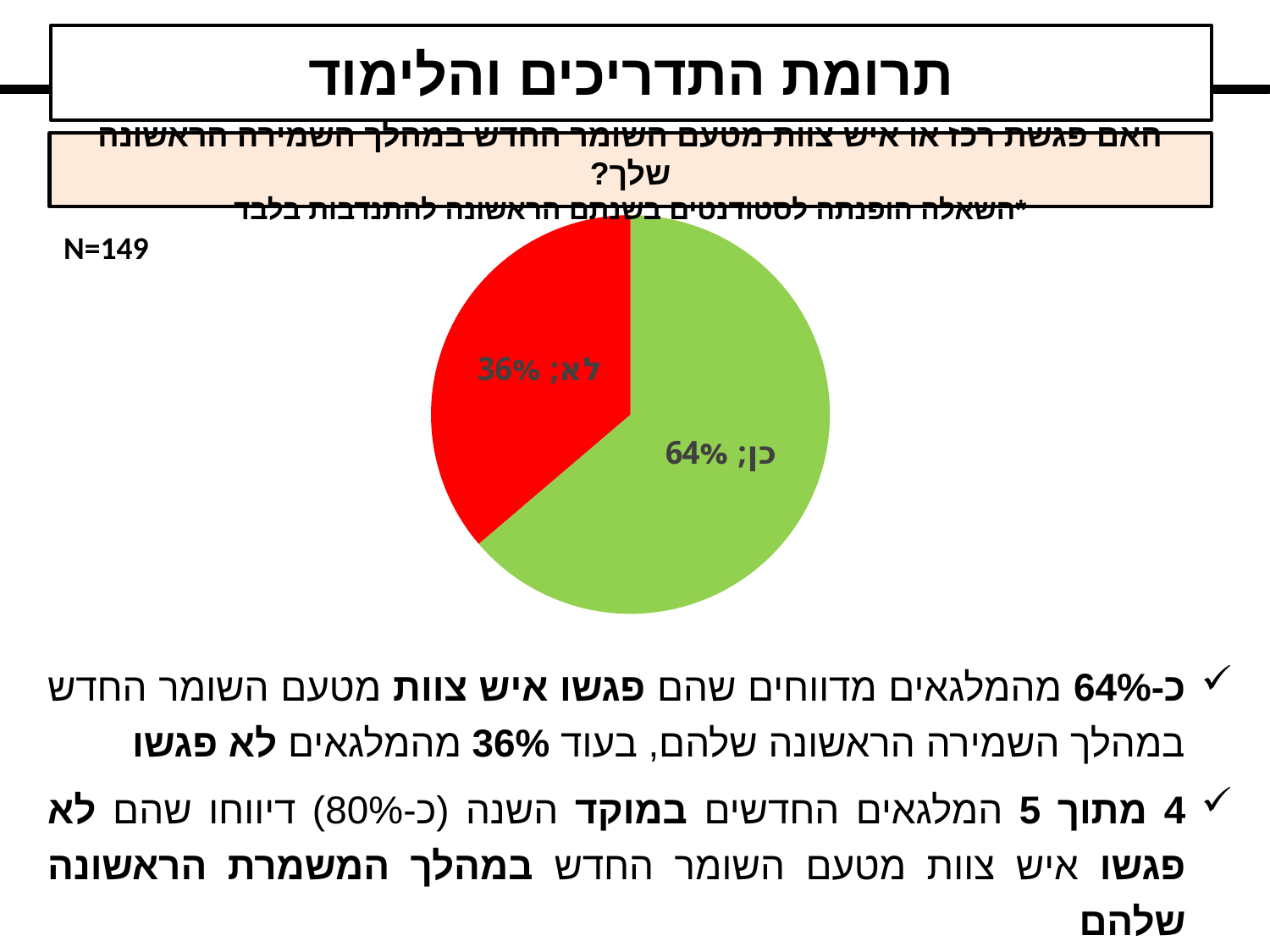
Which slice of the pie chart is the largest? כן What share of the pie does the "לא" slice represent? 36% What colour is the "כן" slice of the pie chart? green Which is larger in the pie chart, the "כן" slice or the "לא" slice? כן How many slices does the pie chart have? 2 What is the sample size (N) shown next to the pie chart? N=149 What percentage of the pie chart is labelled "כן"? 64% Which slice of the pie chart is the smallest? לא What kind of chart is shown on the slide? pie chart What colour is the "לא" slice of the pie chart? red What is the difference in percentage points between the "כן" slice and the "לא" slice? 28 What percentage of the pie chart is labelled "לא"? 36%